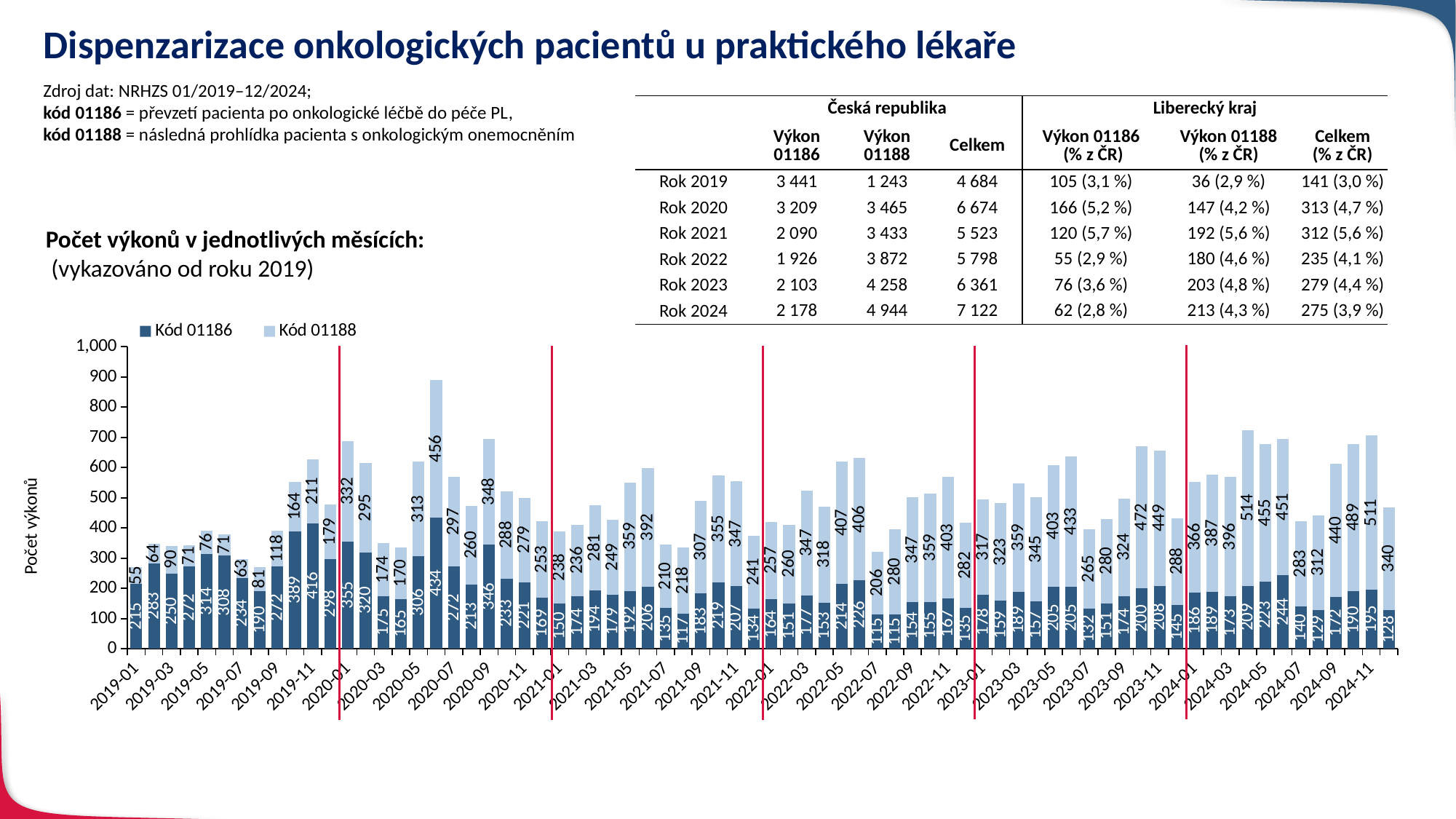
What is the total height of the stacked bar for 2024-11 (Kód 01186 plus Kód 01188)? 706 How many series does the chart legend list? 2 What is the highest Kód 01186 value labelled on the chart? 434 Which month has the larger Kód 01186 value, 2019-11 or 2024-11? 2019-11 What is the value of Kód 01188 for 2024-11? 511 What kind of chart is shown on the slide? Stacked bar chart What is the value of Kód 01186 for 2019-01? 215 What is the total height of the stacked bar for 2019-01 (Kód 01186 plus Kód 01188)? 270 Is the total stacked bar for 2020-01 greater or less than 600? greater How much larger is the Kód 01188 value for 2024-11 than for 2019-01? 456 What is the value of Kód 01186 for 2021-01? 150 Does the Kód 01188 value rise or fall overall from 2019-01 to 2024-11? Rises